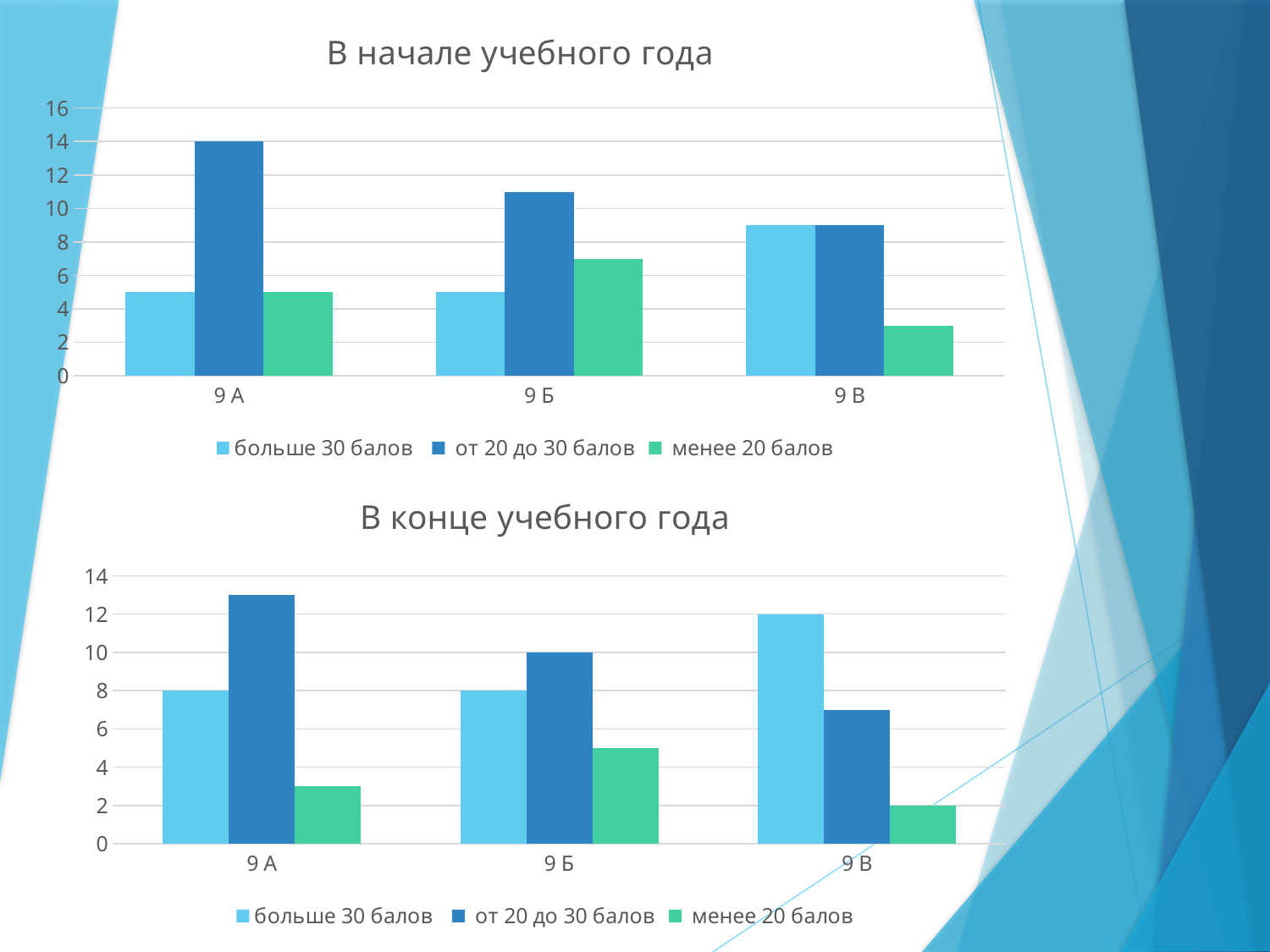
In the chart titled "В начале учебного года", what is the value for "от 20 до 30 балов" in class 9 А? 14 In the chart titled "В начале учебного года", is the value for "менее 20 балов" in class 9 Б greater or less than 6? greater In the chart titled "В конце учебного года", what is the difference between "больше 30 балов" in class 9 В and "больше 30 балов" in class 9 А? 4 What type of chart is the chart titled "В конце учебного года"? bar chart In the chart titled "В начале учебного года", how many series does the legend list? 3 In the chart titled "В конце учебного года", what is the value for "менее 20 балов" in class 9 В? 2 In the chart titled "В конце учебного года", which class has the lowest value for "менее 20 балов"? 9 В In the chart titled "В начале учебного года", is the value for "больше 30 балов" in class 9 В greater or less than 8? greater In the chart titled "В конце учебного года", what is the value for "от 20 до 30 балов" in class 9 Б? 10 In the chart titled "В конце учебного года", what is the value for "больше 30 балов" in class 9 В? 12 In the chart titled "В конце учебного года", how many classes are shown on the x axis? 3 In the chart titled "В начале учебного года", which class has the highest value for "от 20 до 30 балов"? 9 А